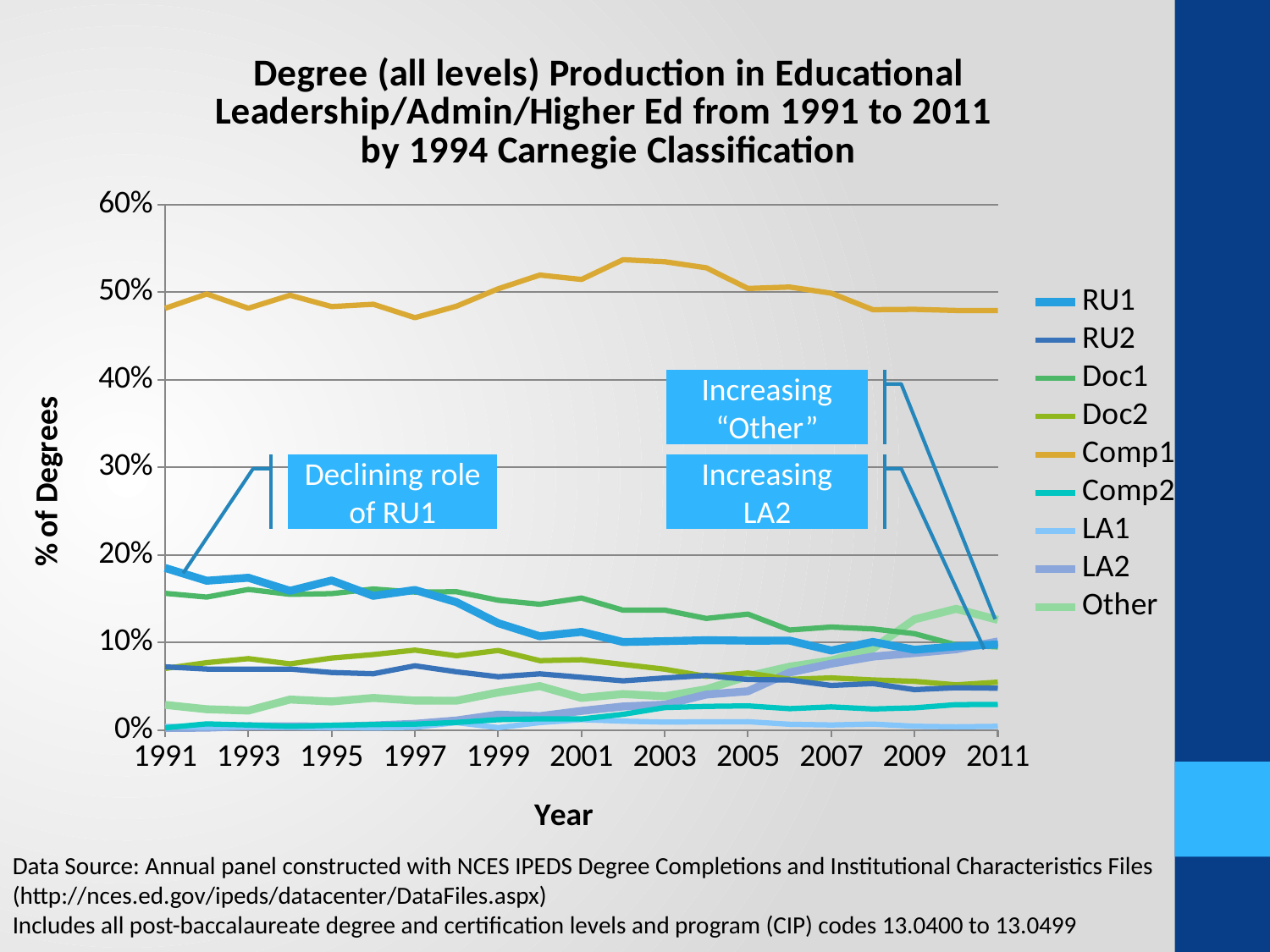
Is the value for Comp1 in 2002 greater or less than 50%? greater Does the Other series rise or fall from 1991 to 2011? Rise Is the value for RU1 in 1991 greater or less than 20%? less Is the value for LA1 in 2011 greater or less than 10%? less What is the label on the vertical axis of the chart? % of Degrees Which series has the highest values across the whole period from 1991 to 2011? Comp1 How many series does the legend list? 9 In 1991, which is larger, the value for Doc1 or the value for Doc2? Doc1 What kind of chart is shown on the slide? Line chart Does the RU1 series rise or fall from 1991 to 2011? Fall